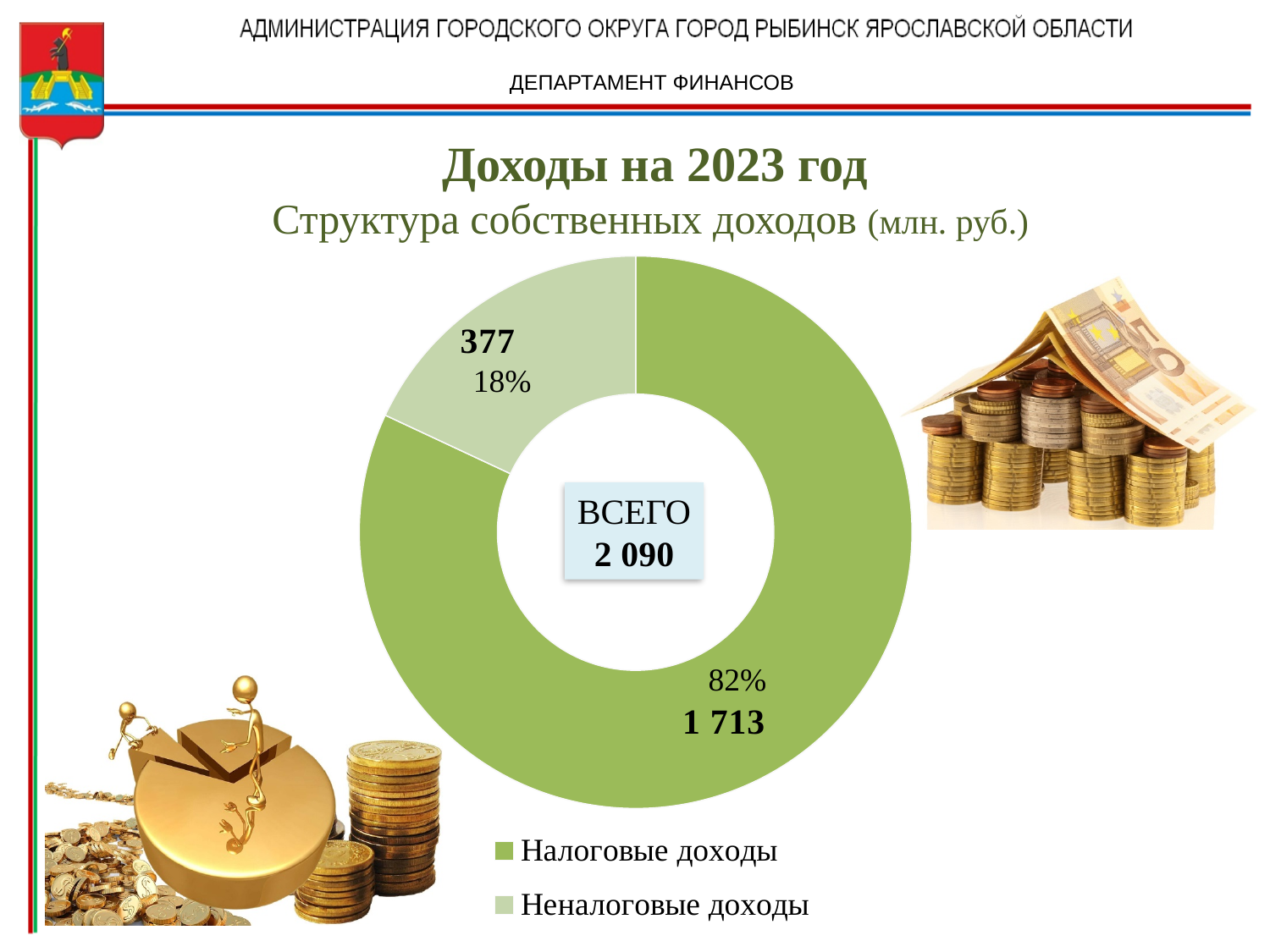
What is the value for Неналоговые доходы? 377 What is the value for Налоговые доходы? 1 713 Which category is the smallest? Неналоговые доходы What kind of chart is shown on the slide? Pie chart (doughnut) What share of the pie does Налоговые доходы take? 82% Which is larger, Налоговые доходы or Неналоговые доходы? Налоговые доходы How many categories does the chart show? 2 Which category is the largest? Налоговые доходы What is the difference between Налоговые доходы and Неналоговые доходы? 1 336 What share of the pie does Неналоговые доходы take? 18% What unit is stated in the chart subtitle? млн. руб. What is the total shown in the centre of the chart (ВСЕГО)? 2 090